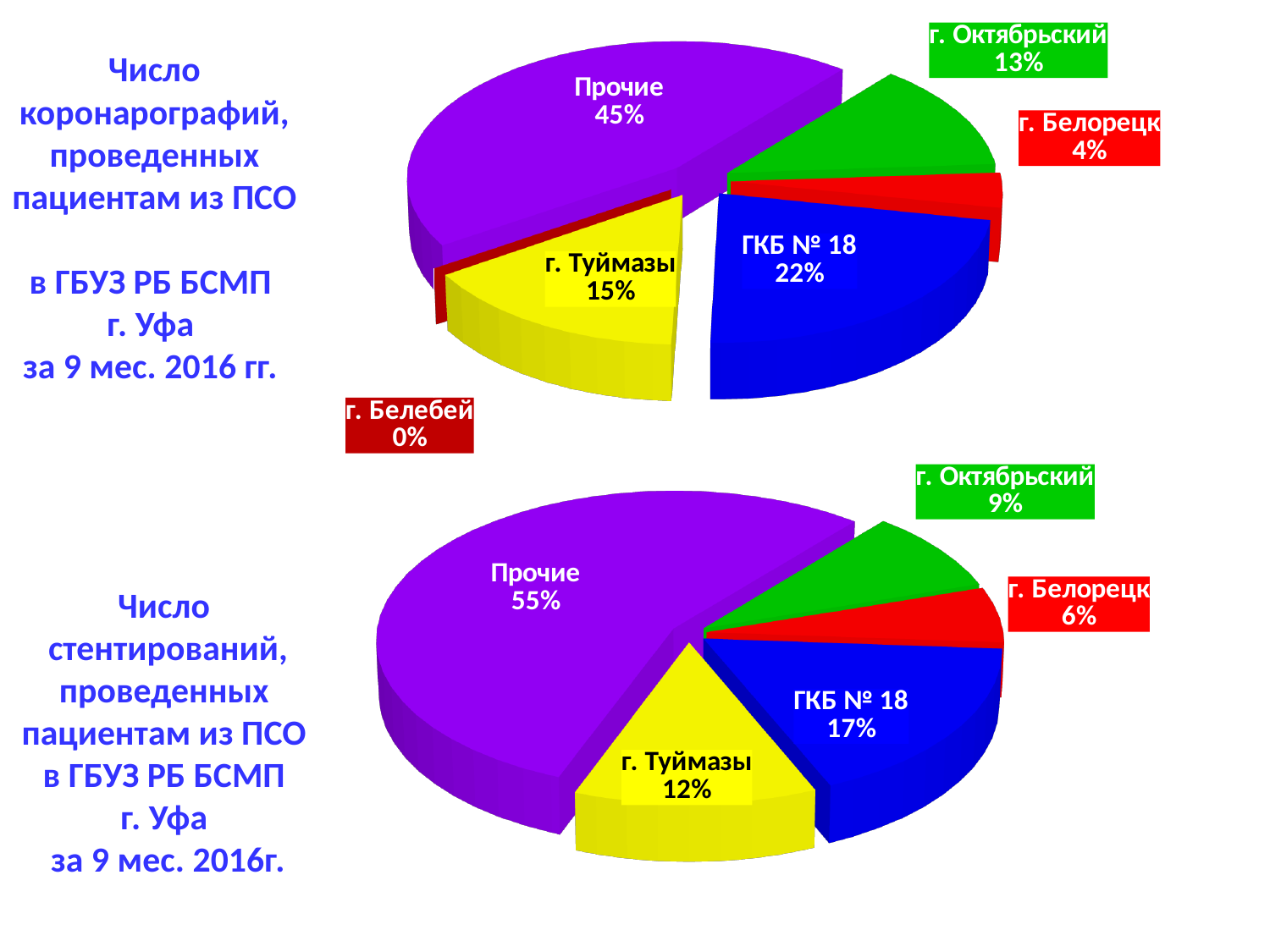
In the top pie chart (number of coronary angiographies), which category has the largest share? Прочие In the bottom pie chart (number of stentings), which category has the smallest share? г. Белорецк In the bottom pie chart (number of stentings), what is the difference between the shares of ГКБ № 18 and г. Октябрьский? 8% In the top pie chart (number of coronary angiographies), what share is labelled for ГКБ № 18? 22% In the top pie chart (number of coronary angiographies), what share is labelled for Прочие? 45% In the top pie chart (number of coronary angiographies), what is the difference between the shares of г. Туймазы and г. Октябрьский? 2% In the top pie chart (number of coronary angiographies), how many categories are labelled? 6 In the bottom pie chart (number of stentings), what share is labelled for г. Белорецк? 6% In the top pie chart (number of coronary angiographies), what share is labelled for г. Белебей? 0% In the bottom pie chart (number of stentings), what share is labelled for Прочие? 55% What type of chart is used for the number of stentings at the bottom of the slide? Pie chart In the bottom pie chart (number of stentings), which is larger: the share of ГКБ № 18 or the share of г. Туймазы? ГКБ № 18